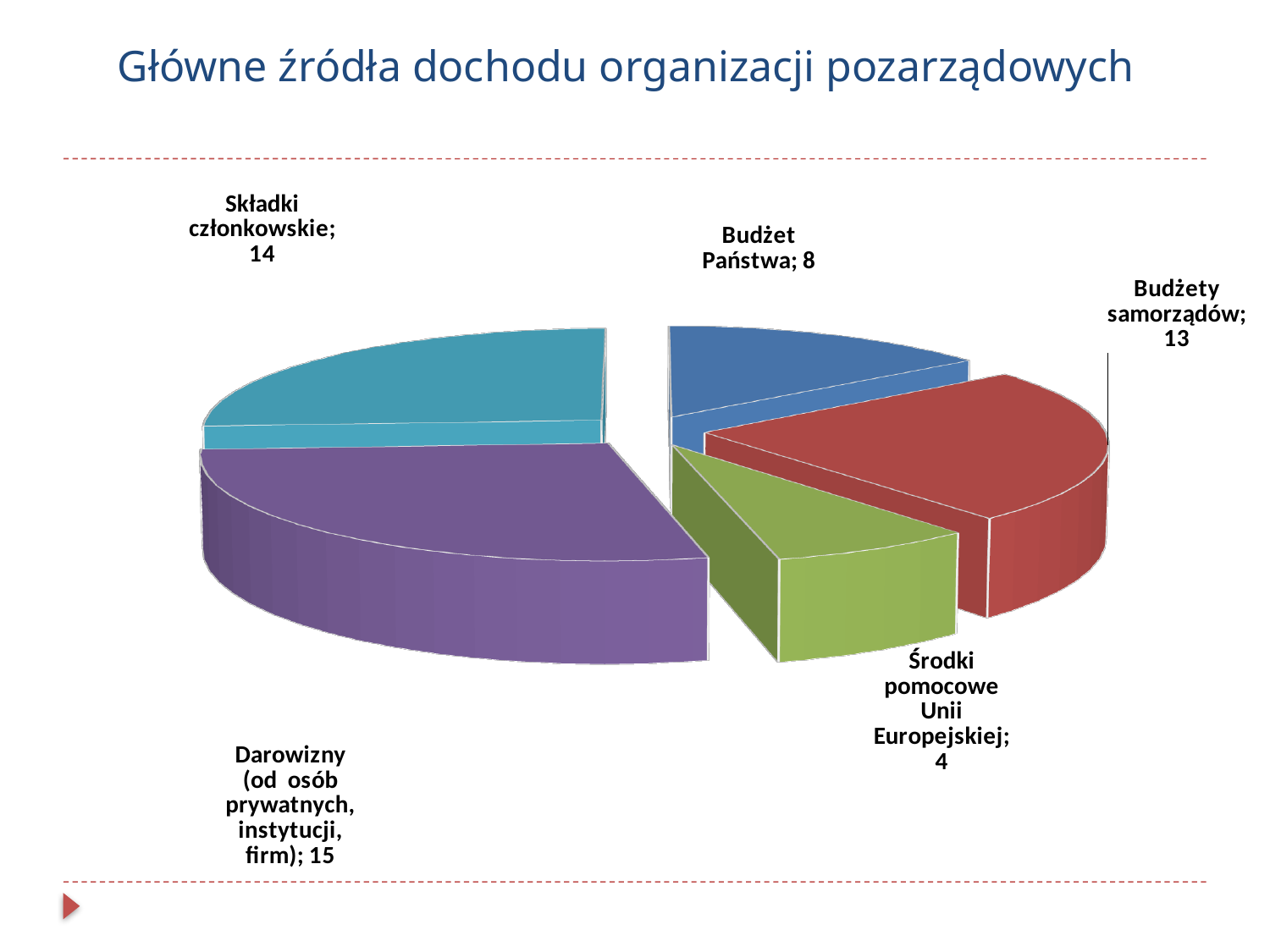
What type of chart is shown on the slide? Pie chart What is the difference between the values for Darowizny and Środki pomocowe Unii Europejskiej? 11 What is the value for Środki pomocowe Unii Europejskiej? 4 What is the value for Budżet Państwa? 8 How many slices does the pie chart have? 5 Which category has the lowest value? Środki pomocowe Unii Europejskiej What is the value for Darowizny (od osób prywatnych, instytucji, firm)? 15 What is the value for Składki członkowskie? 14 Which category has the highest value? Darowizny (od osób prywatnych, instytucji, firm) What is the title of the slide? Główne źródła dochodu organizacji pozarządowych Which is larger, Budżety samorządów or Budżet Państwa? Budżety samorządów What is the value for Budżety samorządów? 13